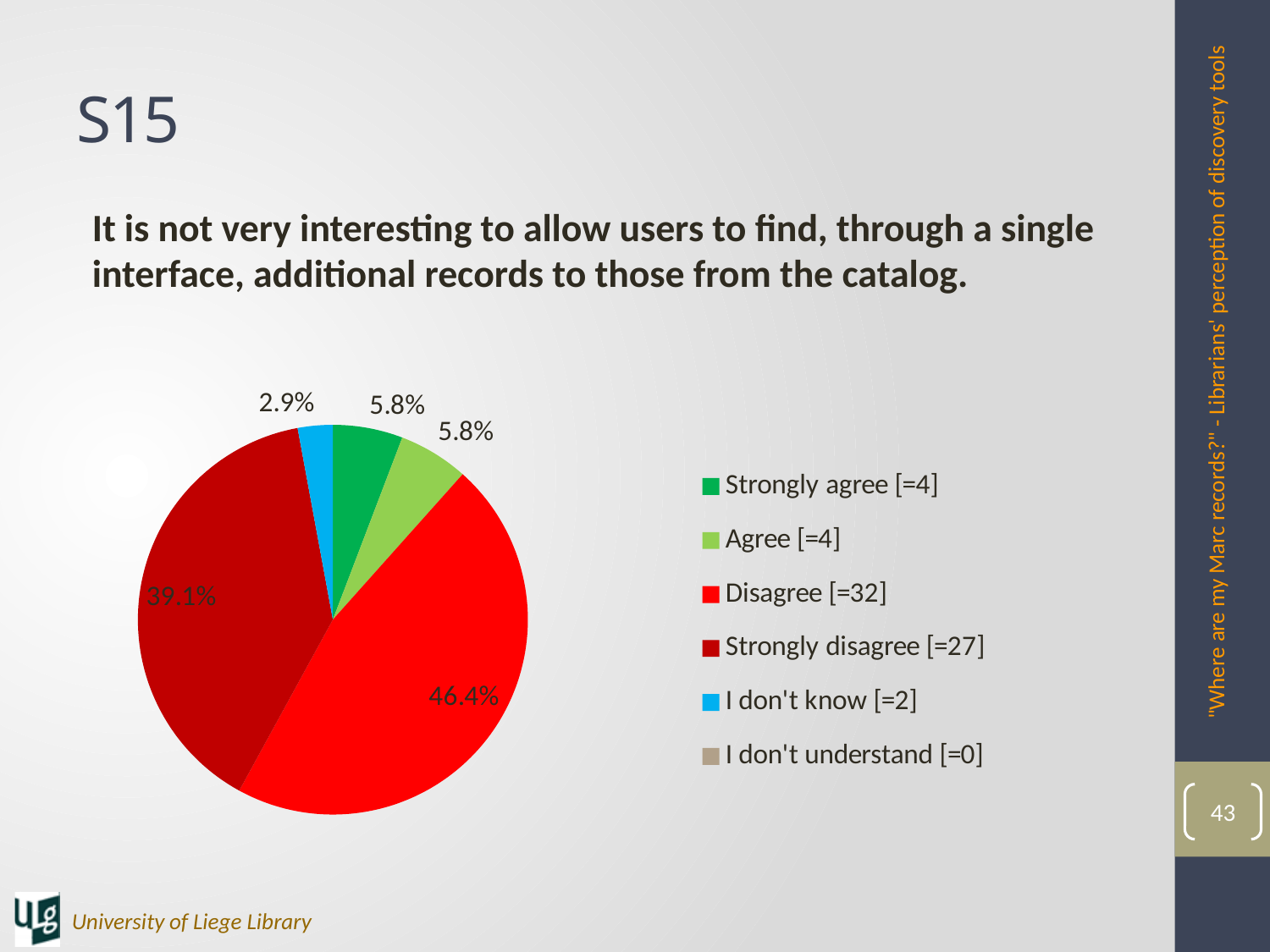
What share of the pie does the Strongly disagree slice represent? 39.1% What share of the pie does the Disagree slice represent? 46.4% How many respondents chose Strongly disagree according to the legend? 27 What share of the pie does the I don't know slice represent? 2.9% What kind of chart is shown on the slide? pie chart How many respondents chose Disagree according to the legend? 32 How many categories does the legend list? 6 Which category has the largest slice of the pie? Disagree Which category with a non-zero count has the smallest slice of the pie? I don't know What is the difference in percentage points between the Disagree and Strongly disagree slices? 7.3% Which is larger, the Strongly disagree slice or the Agree slice? Strongly disagree